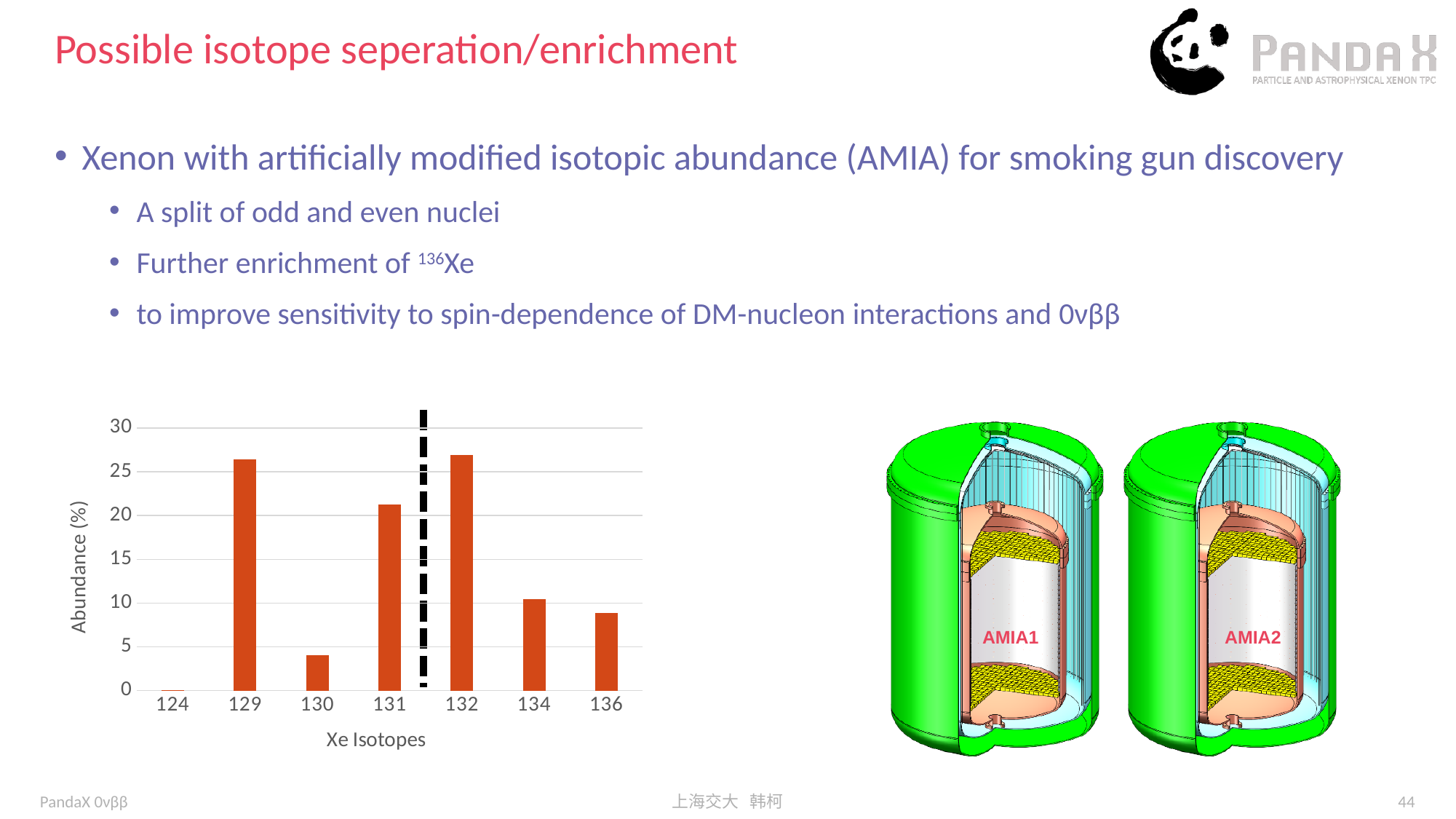
Which has the higher abundance, isotope 130 or isotope 136? 136 What is the label of the vertical axis of the chart? Abundance (%) Is the abundance of isotope 131 greater or less than 20? greater What is the label of the horizontal axis of the chart? Xe Isotopes Is the abundance of isotope 129 greater or less than 25? greater Is the abundance of isotope 136 greater or less than 10? less What kind of chart is shown on the slide? bar chart Which has the higher abundance, isotope 131 or isotope 134? 131 Which Xe isotope has the lowest abundance in the chart? 124 How many Xe isotopes are plotted on the x axis of the chart? 7